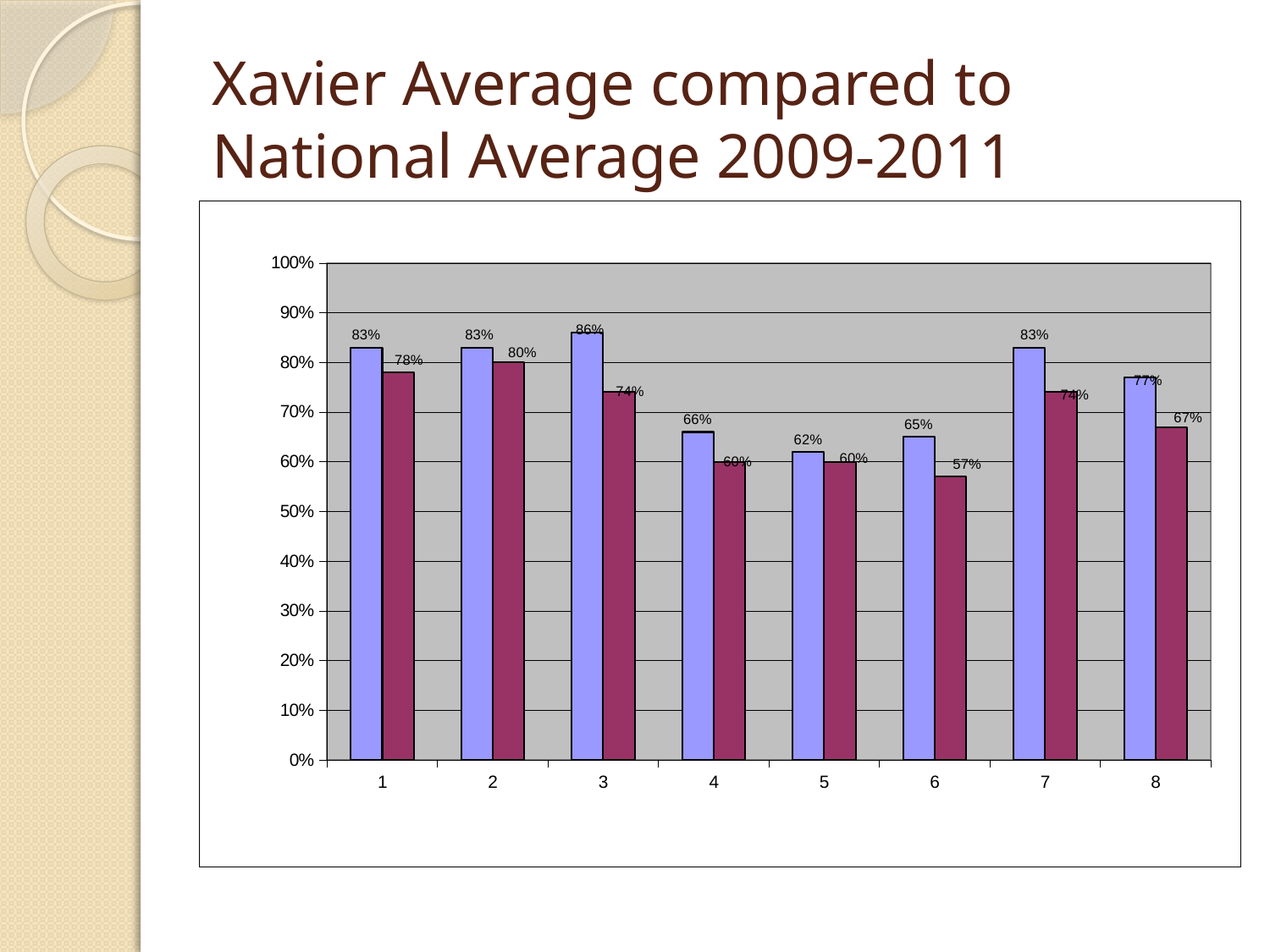
What is the value of the blue bar for category 3? 86% Which category has the lowest purple bar? 6 What is the title of the slide containing the chart? Xavier Average compared to National Average 2009-2011 Which category has the lowest blue bar? 5 What is the difference between the blue bar and the purple bar for category 7? 9% How many categories are shown on the x axis? 8 What is the value of the purple bar for category 6? 57% What is the value of the purple bar for category 8? 67% What kind of chart is shown on the slide? bar chart Which category has the highest blue bar? 3 What is the difference between the blue bar and the purple bar for category 3? 12% Which is larger for category 2, the blue bar or the purple bar? the blue bar